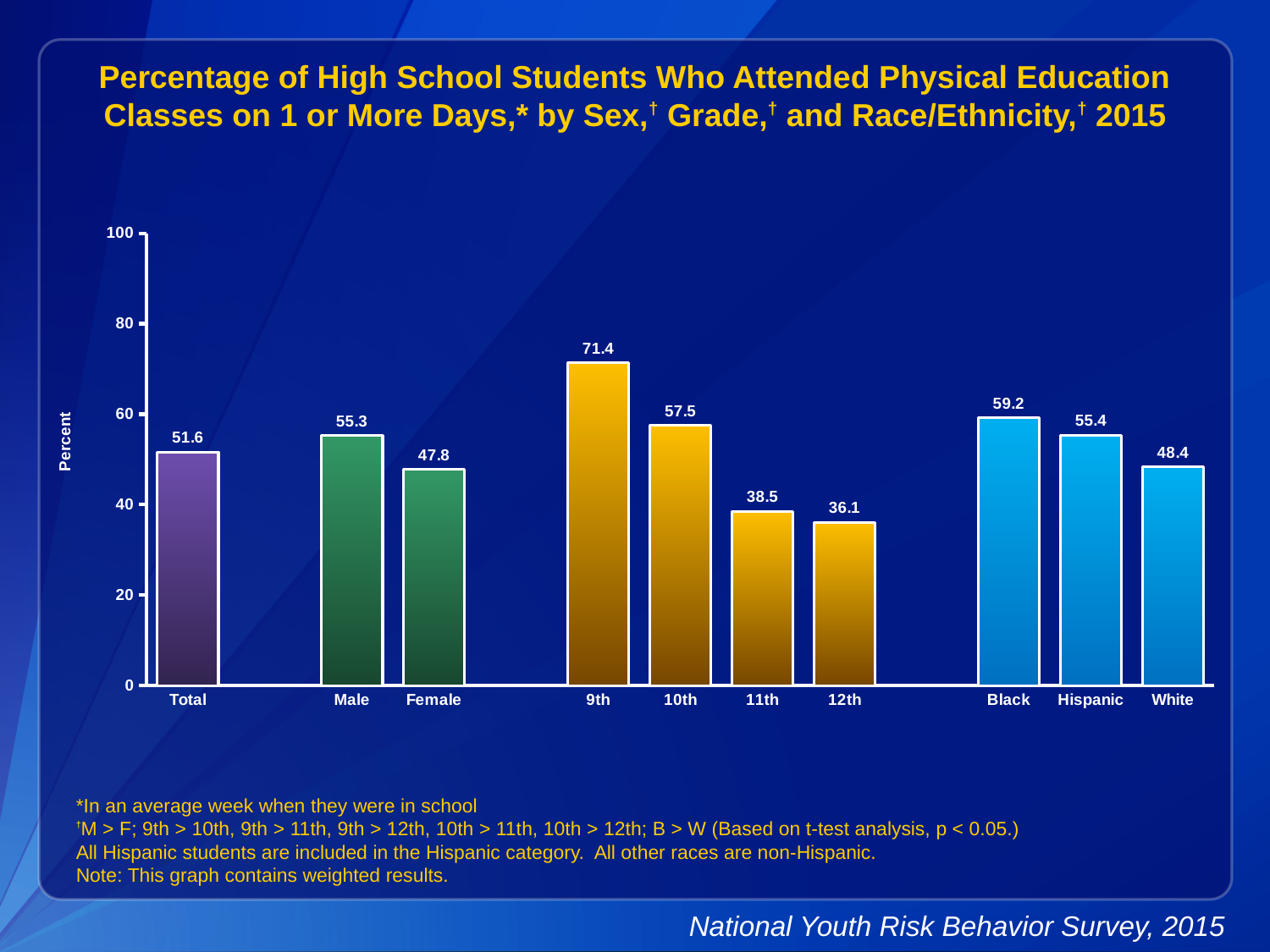
What is the difference between the values for Male and Female? 7.5 What is the value for Hispanic? 55.4 What kind of chart is shown on the slide? bar chart What is the difference between the values for 9th and 10th grade? 13.9 Which is larger, the value for Black or the value for White? Black What is the value for Total? 51.6 What is the value for Female? 47.8 How many bars are shown in the chart? 10 Which category has the lowest value? 12th Which category has the highest value? 9th What is the value for 12th grade? 36.1 Is the value for 11th grade greater or less than 40? less